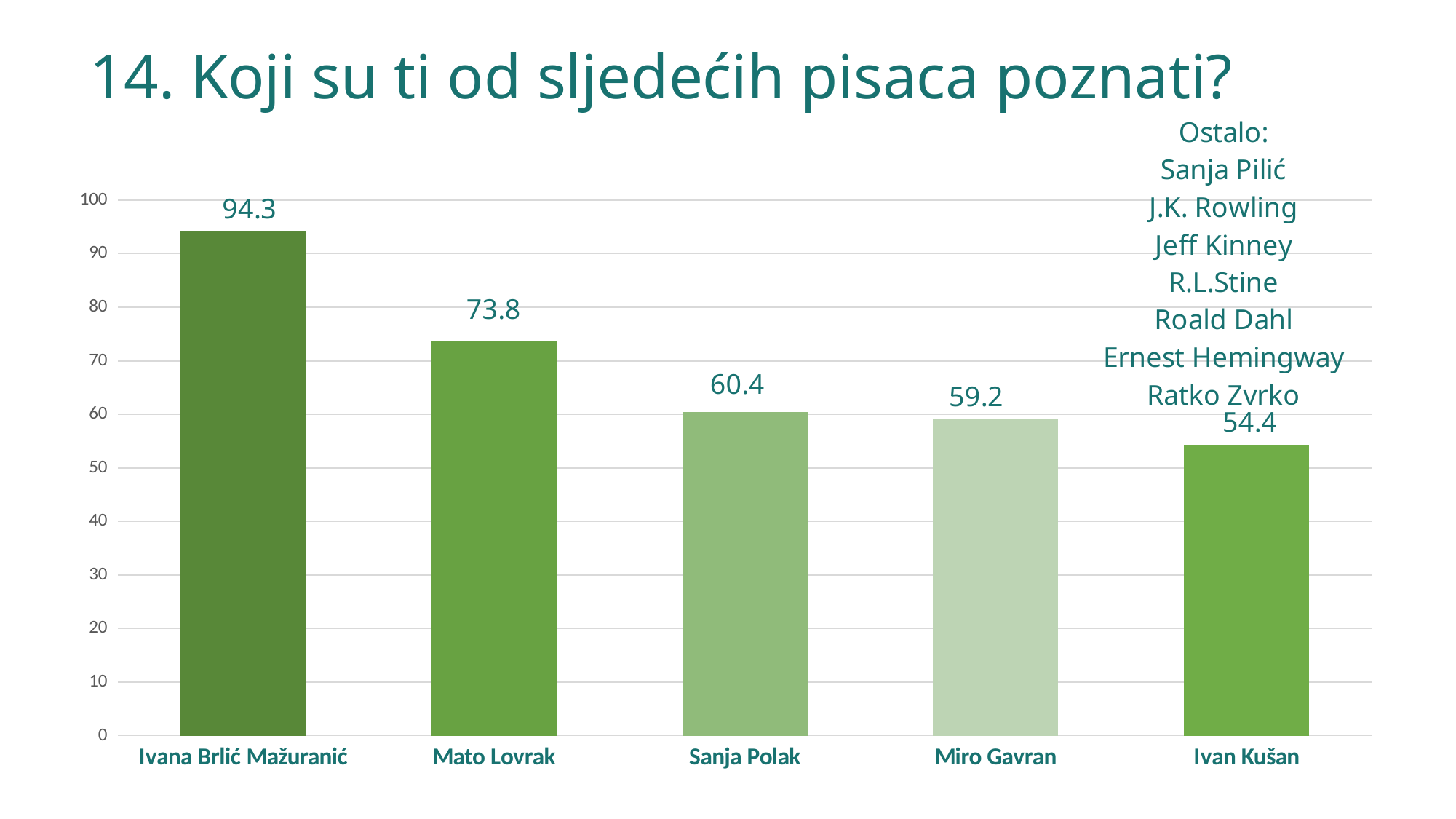
What is the value for Ivan Kušan? 54.4 What is the difference between the values for Miro Gavran and Ivan Kušan? 4.8 What is the value for Mato Lovrak? 73.8 How many writers are shown as bars in the chart? 5 Which writer has the highest value? Ivana Brlić Mažuranić Which is larger, the value for Mato Lovrak or the value for Sanja Polak? Mato Lovrak What is the value for Sanja Polak? 60.4 What is the value for Ivana Brlić Mažuranić? 94.3 What kind of chart is shown on the slide? Bar chart Do the values rise or fall from left to right across the bars? Fall What is the difference between the values for Ivana Brlić Mažuranić and Mato Lovrak? 20.5 Which writer has the lowest value? Ivan Kušan